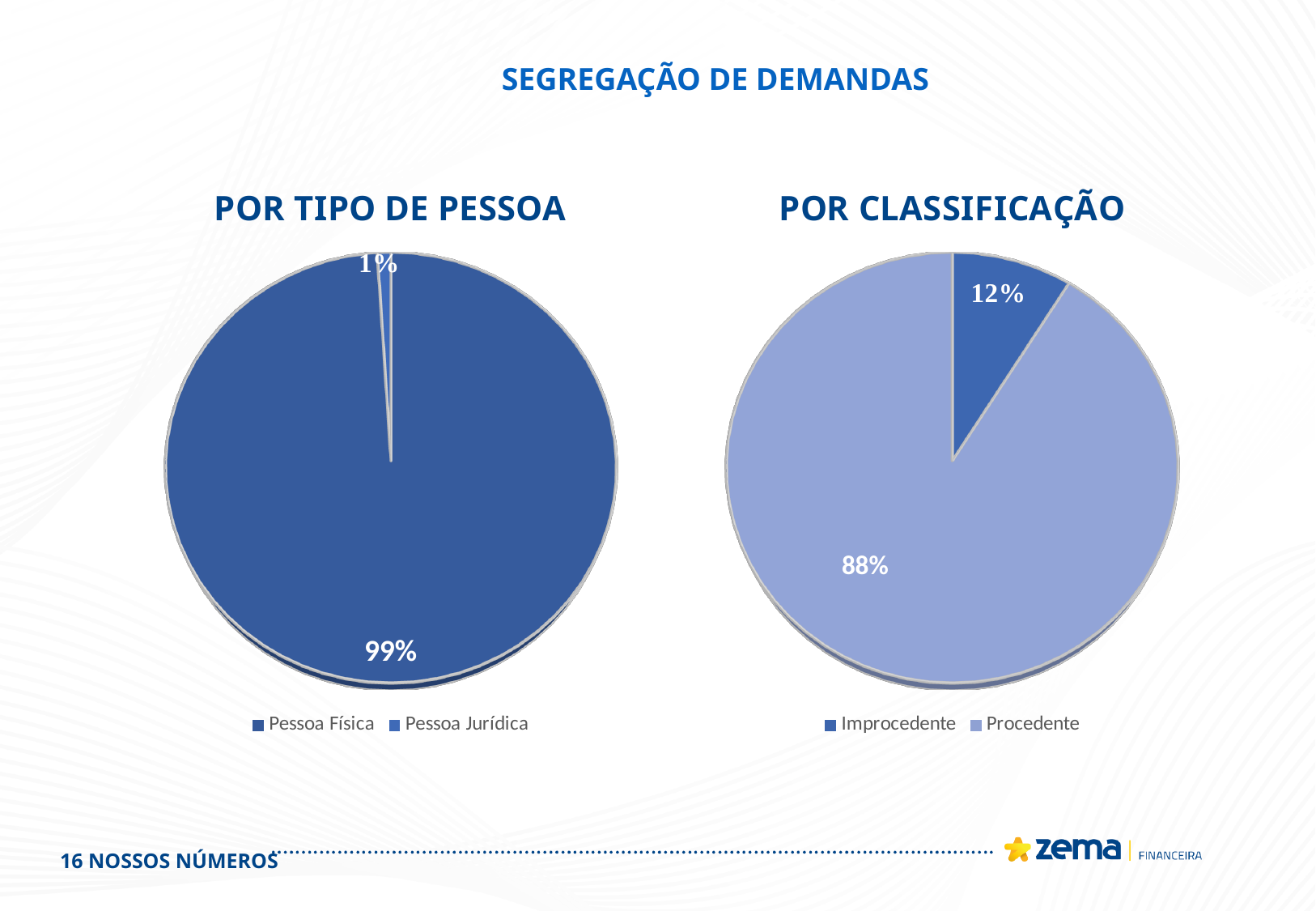
What kind of chart is 'POR TIPO DE PESSOA'? Pie chart How many categories does the legend of the 'POR CLASSIFICAÇÃO' chart list? 2 In the 'POR TIPO DE PESSOA' chart, what is the difference in percentage points between Pessoa Física and Pessoa Jurídica? 98 In the 'POR CLASSIFICAÇÃO' chart, what is the difference in percentage points between Procedente and Improcedente? 76 In the 'POR CLASSIFICAÇÃO' chart, which category has the smallest slice? Improcedente In the 'POR CLASSIFICAÇÃO' chart, what share of the pie is Procedente? 88% In the 'POR CLASSIFICAÇÃO' chart, which is larger, Improcedente or Procedente? Procedente In the 'POR TIPO DE PESSOA' chart, which category has the largest slice? Pessoa Física In the 'POR TIPO DE PESSOA' chart, what share of the pie is Pessoa Jurídica? 1% What is the overall title of the slide above the two charts? SEGREGAÇÃO DE DEMANDAS In the 'POR TIPO DE PESSOA' chart, what share of the pie is Pessoa Física? 99%